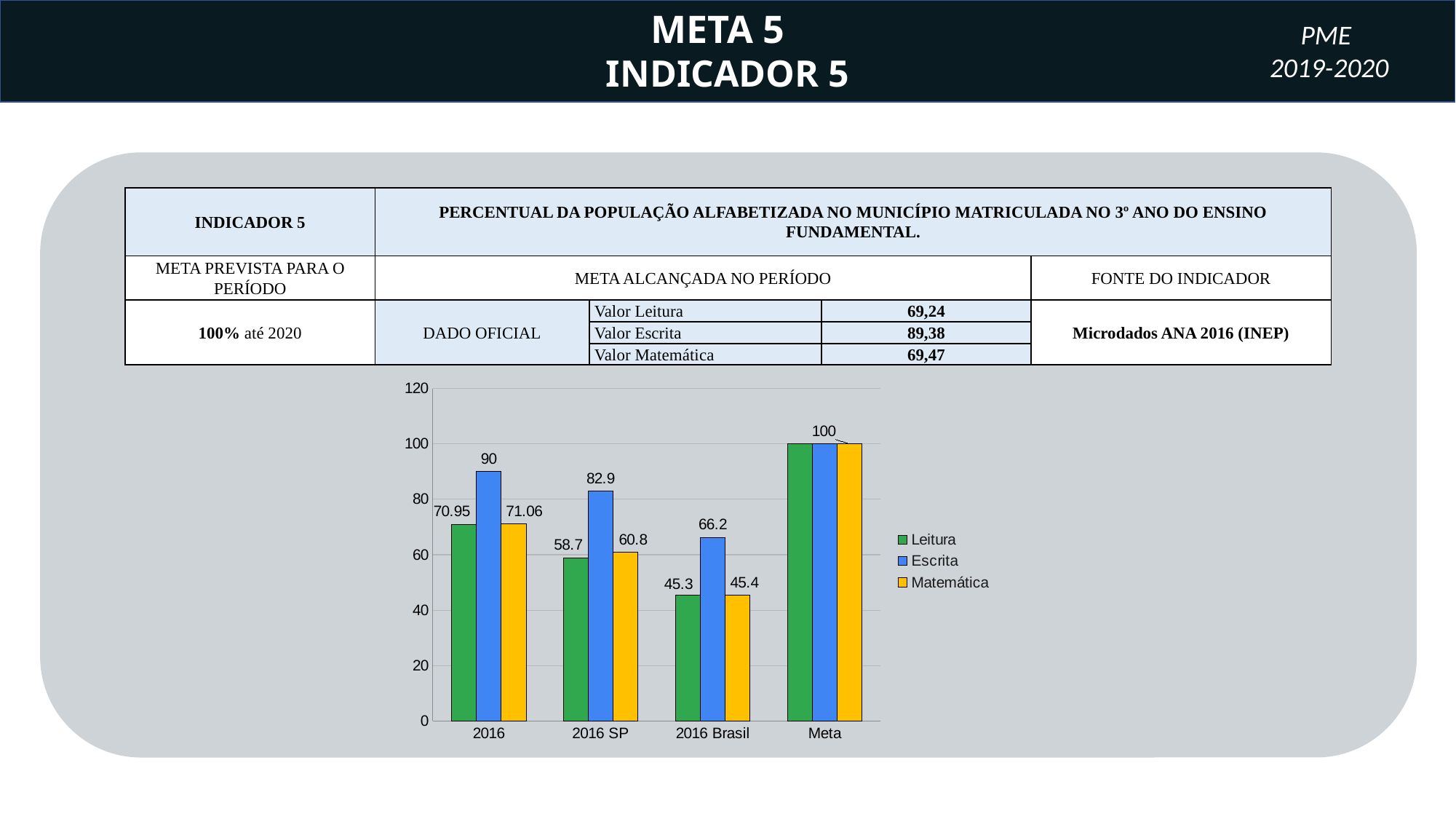
Which category has the lowest Leitura value? 2016 Brasil Which series has the highest value in the 2016 SP group? Escrita What is the value of Matemática for 2016 Brasil? 45.4 What is the difference between the Escrita values for 2016 and 2016 Brasil? 23.8 How many series does the legend list? 3 What kind of chart is shown on the slide? bar chart Is the Escrita value for 2016 Brasil greater or less than 60? greater What colour are the Matemática bars? yellow Which is larger, Matemática for 2016 or Matemática for 2016 SP? Matemática for 2016 What is the value of Escrita for 2016? 90 How many categories are shown on the x axis? 4 What is the value of Leitura for 2016 SP? 58.7